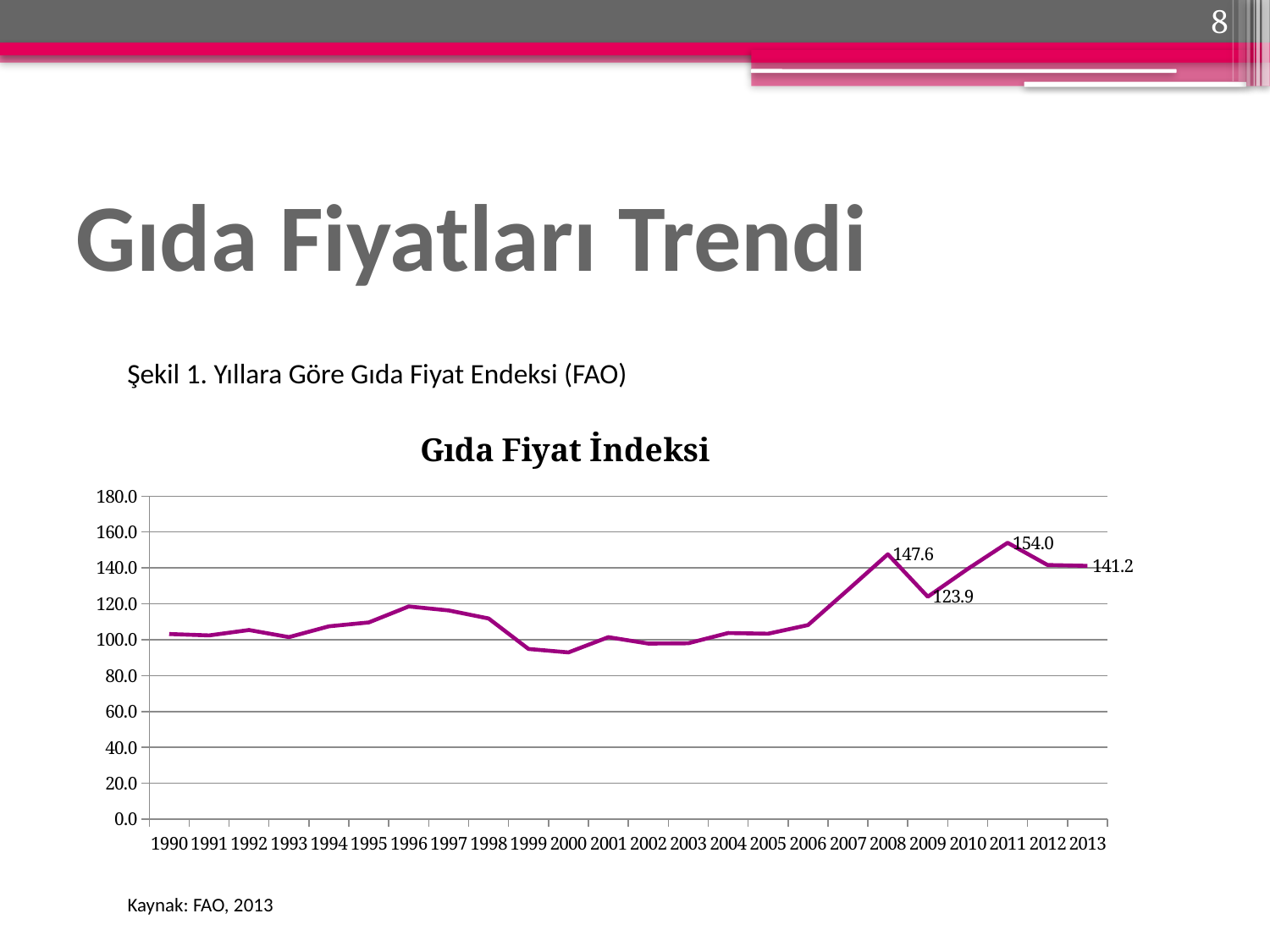
What is the value of the food price index for 2008? 147.6 What is the value of the food price index for 2011? 154.0 What is the value of the food price index for 2009? 123.9 What type of chart is shown on the slide? line chart Is the value for 2000 greater or less than 100? less What is the value of the food price index for 2013? 141.2 What is the title of the chart? Gıda Fiyat İndeksi Which year has the highest food price index value? 2011 What is the difference between the 2011 value and the 2013 value? 12.8 How many years are shown on the x axis? 24 Which year has the larger value, 2008 or 2013? 2008 What is the difference between the 2008 value and the 2009 value? 23.7